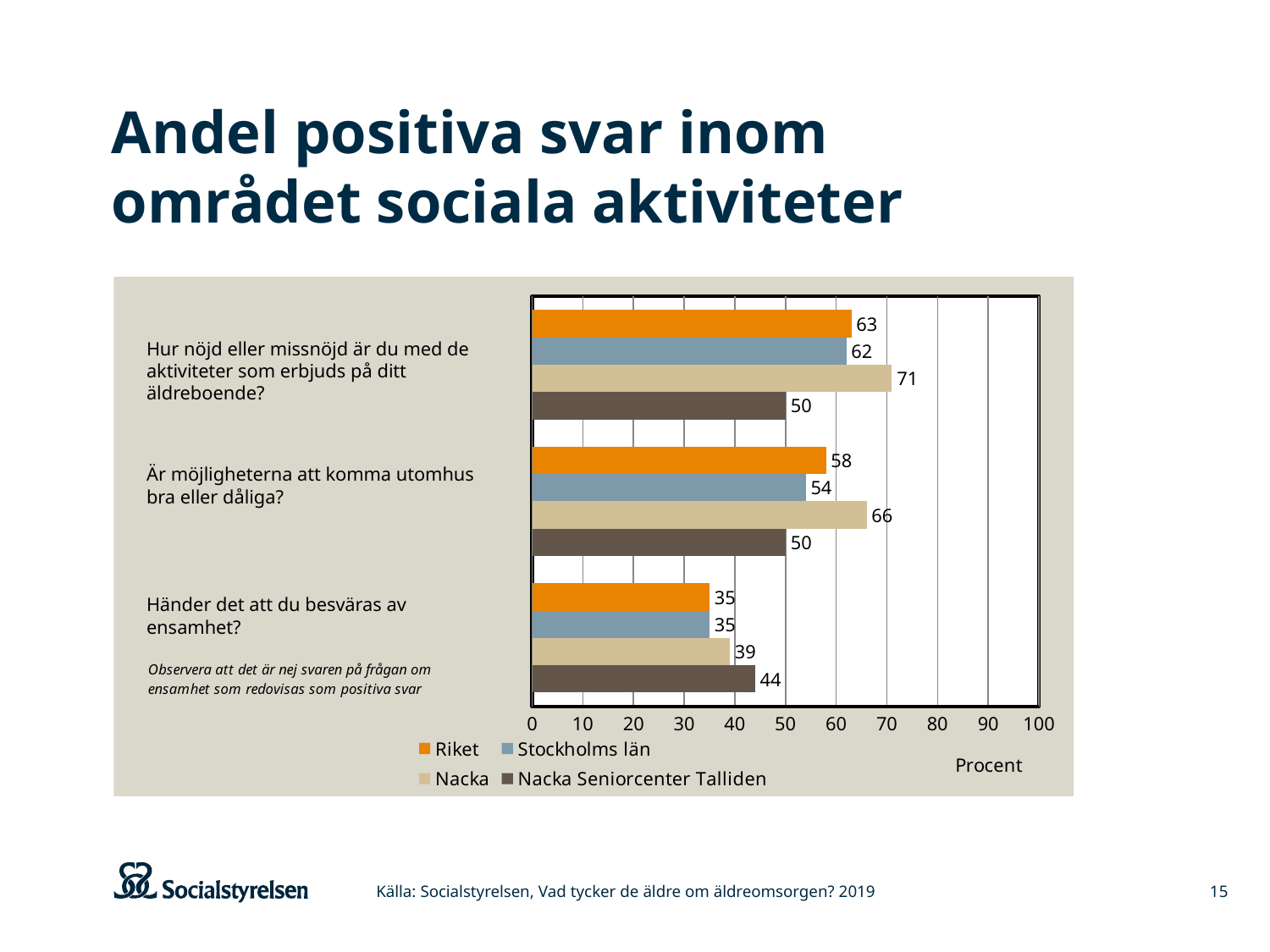
What is the value for Stockholms län on the question "Är möjligheterna att komma utomhus bra eller dåliga?"? 54 What is the value for Riket on the question "Händer det att du besväras av ensamhet?"? 35 How many series does the legend list? 4 Which series has the lowest value on the question "Är möjligheterna att komma utomhus bra eller dåliga?"? Nacka Seniorcenter Talliden What is the difference between Nacka and Nacka Seniorcenter Talliden on the question "Hur nöjd eller missnöjd är du med de aktiviteter som erbjuds på ditt äldreboende?"? 21 What kind of chart is shown on the slide? Bar chart Which is larger on the question "Är möjligheterna att komma utomhus bra eller dåliga?": Riket or Nacka? Nacka What is the label of the x axis? Procent Which series has the highest value on the question "Händer det att du besväras av ensamhet?"? Nacka Seniorcenter Talliden Which series has the highest value on the question "Hur nöjd eller missnöjd är du med de aktiviteter som erbjuds på ditt äldreboende?"? Nacka What is the value for Nacka on the question "Hur nöjd eller missnöjd är du med de aktiviteter som erbjuds på ditt äldreboende?"? 71 What is the value for Nacka Seniorcenter Talliden on the question "Är möjligheterna att komma utomhus bra eller dåliga?"? 50